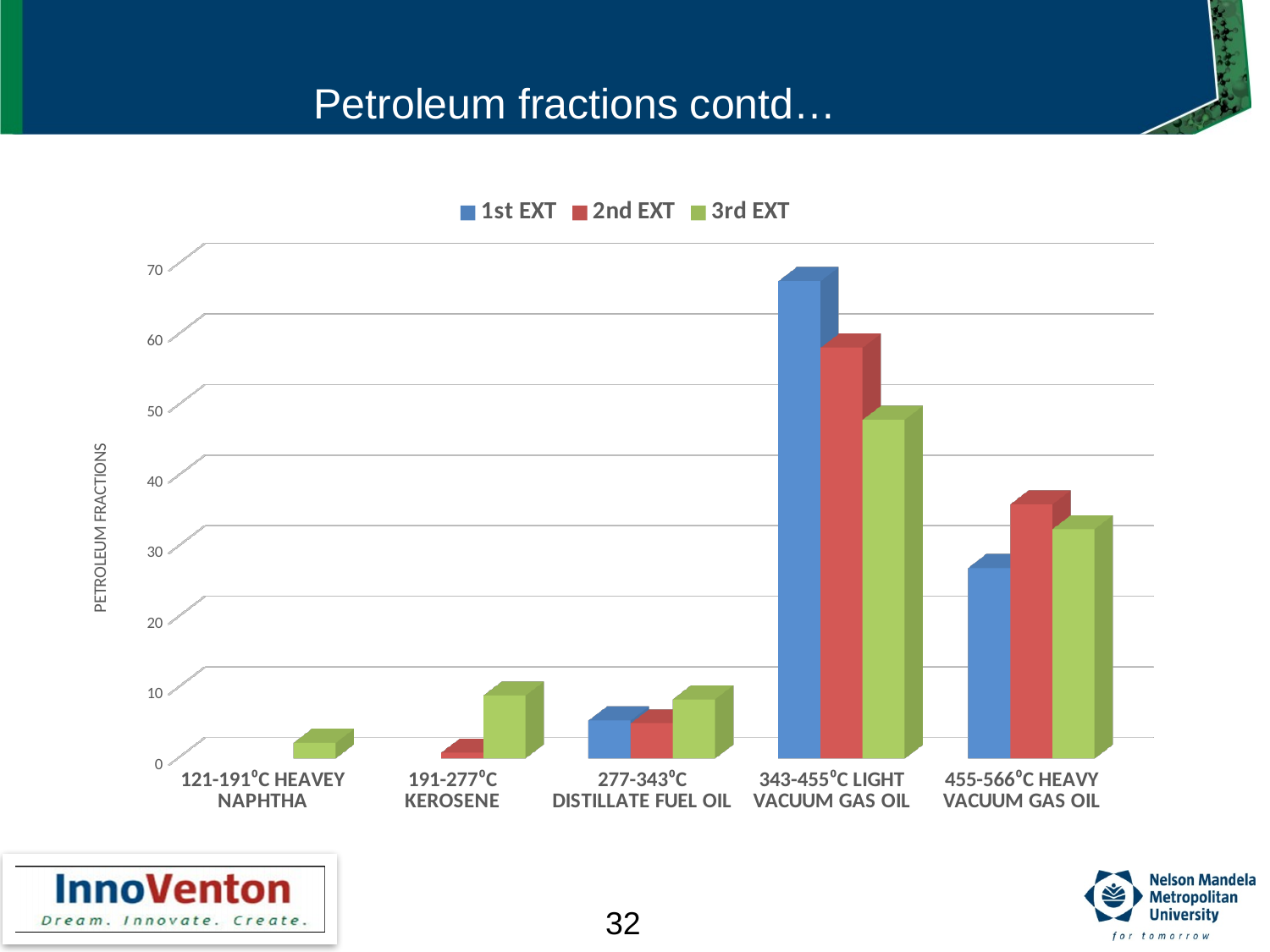
Which category has the highest value for the 3rd EXT series? 343-455°C LIGHT VACUUM GAS OIL What is the title of the vertical axis? PETROLEUM FRACTIONS For 343-455°C LIGHT VACUUM GAS OIL, which series has the larger value, 1st EXT or 3rd EXT? 1st EXT How many petroleum fraction categories are shown on the x axis? 5 For 455-566°C HEAVY VACUUM GAS OIL, which series has the larger value, 1st EXT or 2nd EXT? 2nd EXT Is the 1st EXT value for 455-566°C HEAVY VACUUM GAS OIL greater or less than 30? less What kind of chart is shown on the slide? bar chart Is the 1st EXT value for 343-455°C LIGHT VACUUM GAS OIL greater or less than 60? greater How many series does the legend list? 3 Which category has the highest value for the 1st EXT series? 343-455°C LIGHT VACUUM GAS OIL